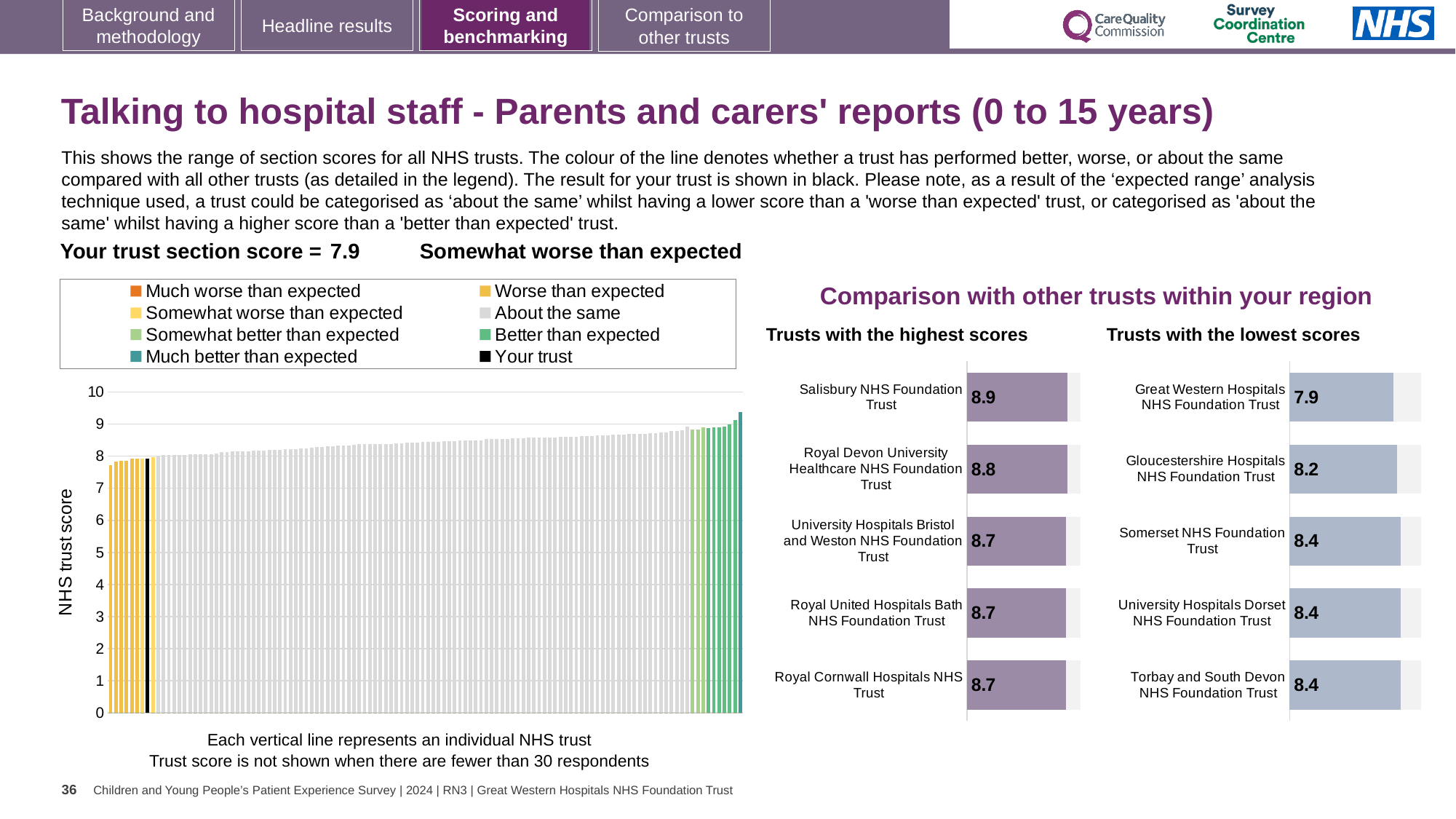
In the main 'NHS trust score' chart, what is the section score for your trust (shown in black)? 7.9 How many entries does the legend of the main 'NHS trust score' chart list? 8 In the 'Trusts with the highest scores' chart, what is the score for Salisbury NHS Foundation Trust? 8.9 In the main 'NHS trust score' chart, do the bar values rise or fall from left to right? Rise In the 'Trusts with the lowest scores' chart, which trust has the lowest score? Great Western Hospitals NHS Foundation Trust In the 'Trusts with the lowest scores' chart, how much higher is the score of Gloucestershire Hospitals NHS Foundation Trust than that of Great Western Hospitals NHS Foundation Trust? 0.3 What kind of chart is the main chart showing the NHS trust score for all trusts? Bar chart In the 'Trusts with the lowest scores' chart, what is the score for Gloucestershire Hospitals NHS Foundation Trust? 8.2 Which has the higher score: Royal Devon University Healthcare NHS Foundation Trust in the highest scores chart or Somerset NHS Foundation Trust in the lowest scores chart? Royal Devon University Healthcare NHS Foundation Trust In the 'Trusts with the highest scores' chart, what is the difference between the scores of Salisbury NHS Foundation Trust and Royal Devon University Healthcare NHS Foundation Trust? 0.1 In the 'Trusts with the highest scores' chart, which trust has the highest score? Salisbury NHS Foundation Trust How many trusts are listed in the 'Trusts with the highest scores' chart? 5